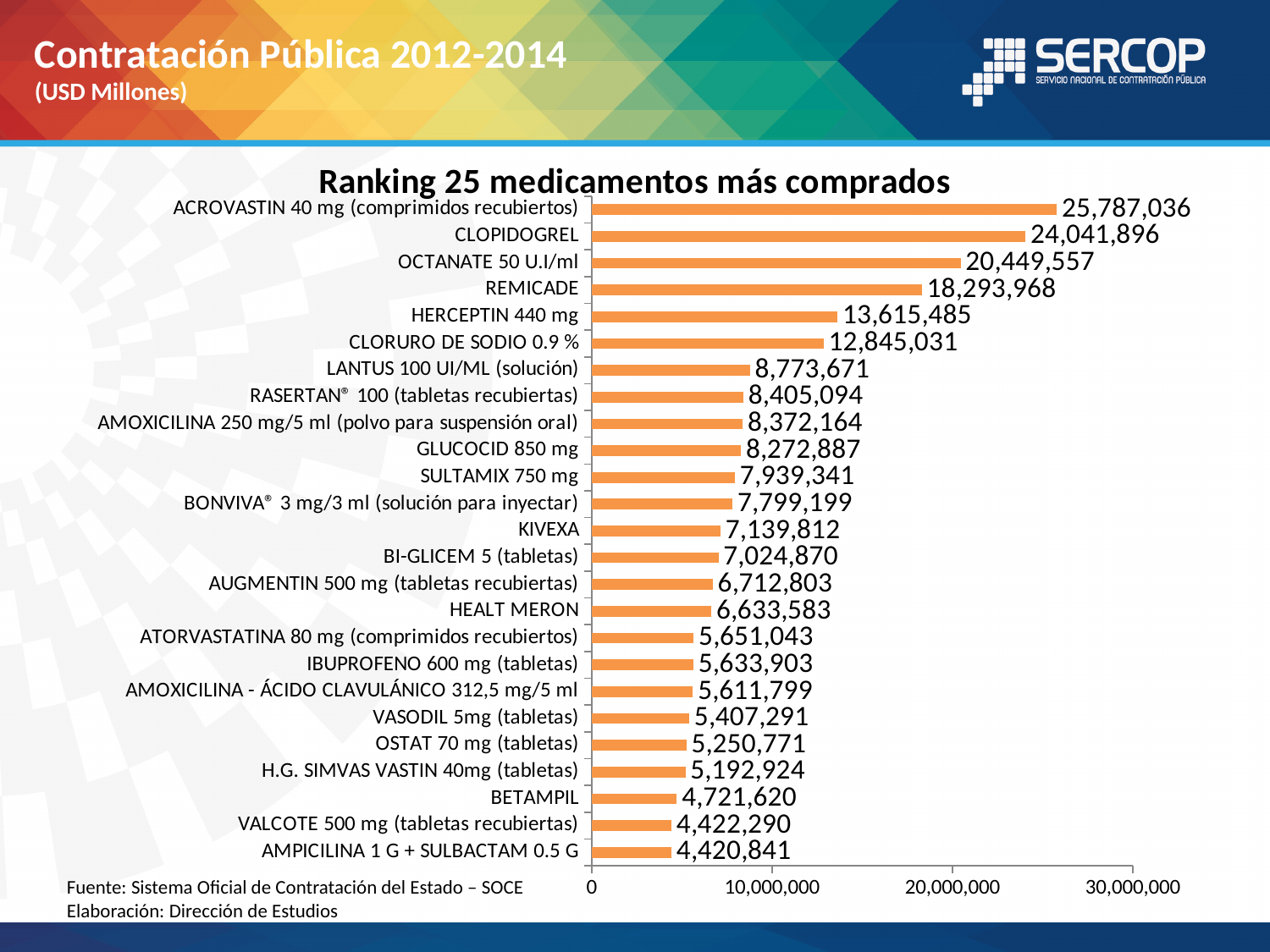
Which medicine has the lowest value? AMPICILINA 1 G + SULBACTAM 0.5 G What is the difference between the values for ACROVASTIN 40 mg (comprimidos recubiertos) and CLOPIDOGREL? 1,745,140 What kind of chart is shown on the slide? bar chart Which medicine has the highest value? ACROVASTIN 40 mg (comprimidos recubiertos) How many medicines are shown in the chart? 25 What is the difference between the values for REMICADE and HERCEPTIN 440 mg? 4,678,483 What is the value for CLOPIDOGREL? 24,041,896 What is the title of the chart? Ranking 25 medicamentos más comprados What is the value for KIVEXA? 7,139,812 Is the value for CLORURO DE SODIO 0.9 % greater or less than 10,000,000? greater What is the value for HERCEPTIN 440 mg? 13,615,485 Which is larger, the value for OCTANATE 50 U.I/ml or the value for REMICADE? OCTANATE 50 U.I/ml